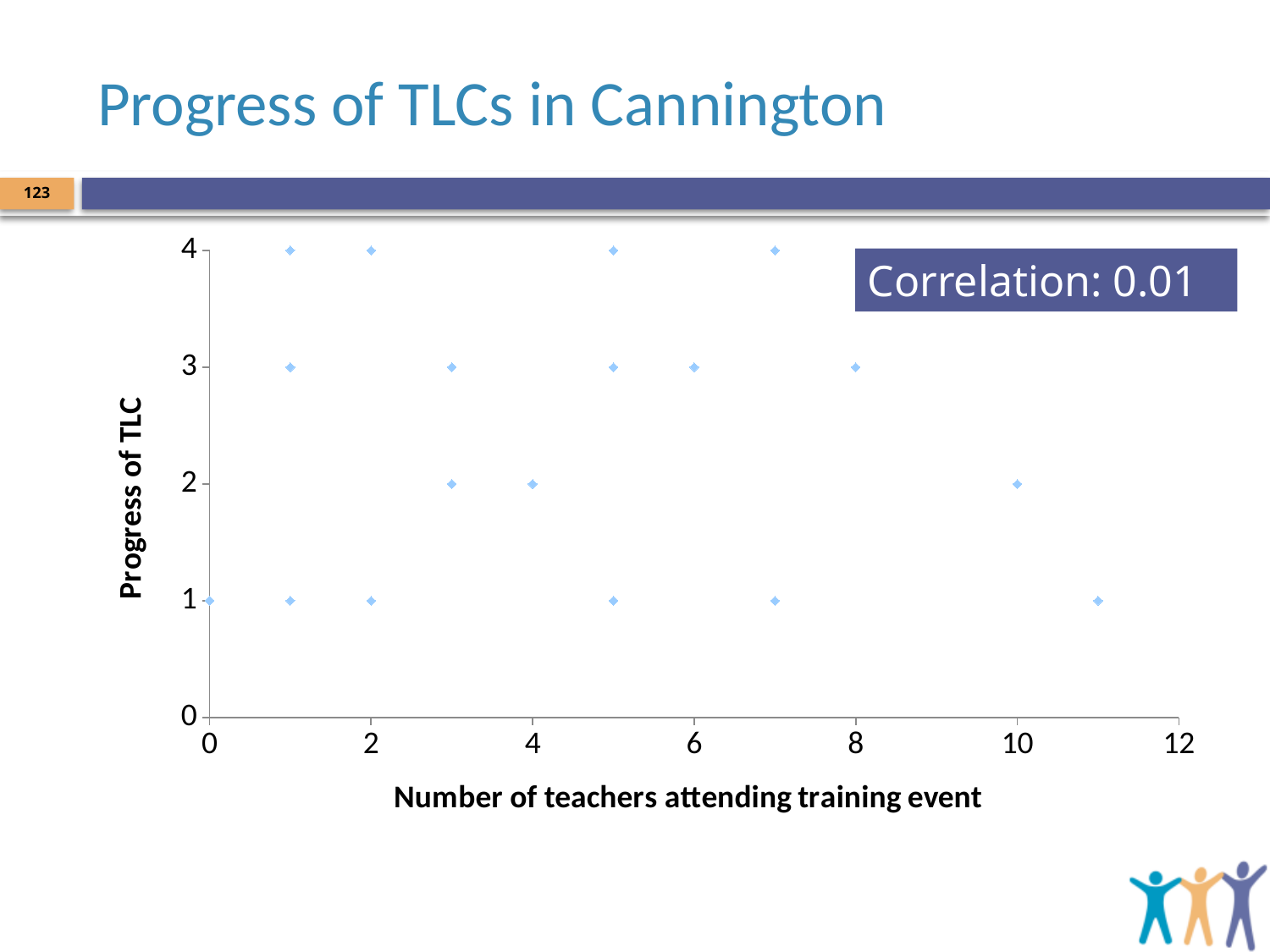
What is the Progress of TLC value for the point at 10 teachers attending? 2 How many points are plotted at a Progress of TLC value of 4? 4 Is the Progress of TLC value for the point at 11 teachers greater or less than 2? less What is the lowest Progress of TLC value reached by any point? 1 What correlation value is stated on the slide? 0.01 What is the Progress of TLC value for the point at 4 teachers attending? 2 What is the label of the x axis? Number of teachers attending training event What is the Progress of TLC value for the point at 0 teachers attending? 1 What kind of chart is shown on the slide? scatter plot What is the highest number of teachers attending a training event shown by any point? 11 What is the Progress of TLC value for the point at 11 teachers attending? 1